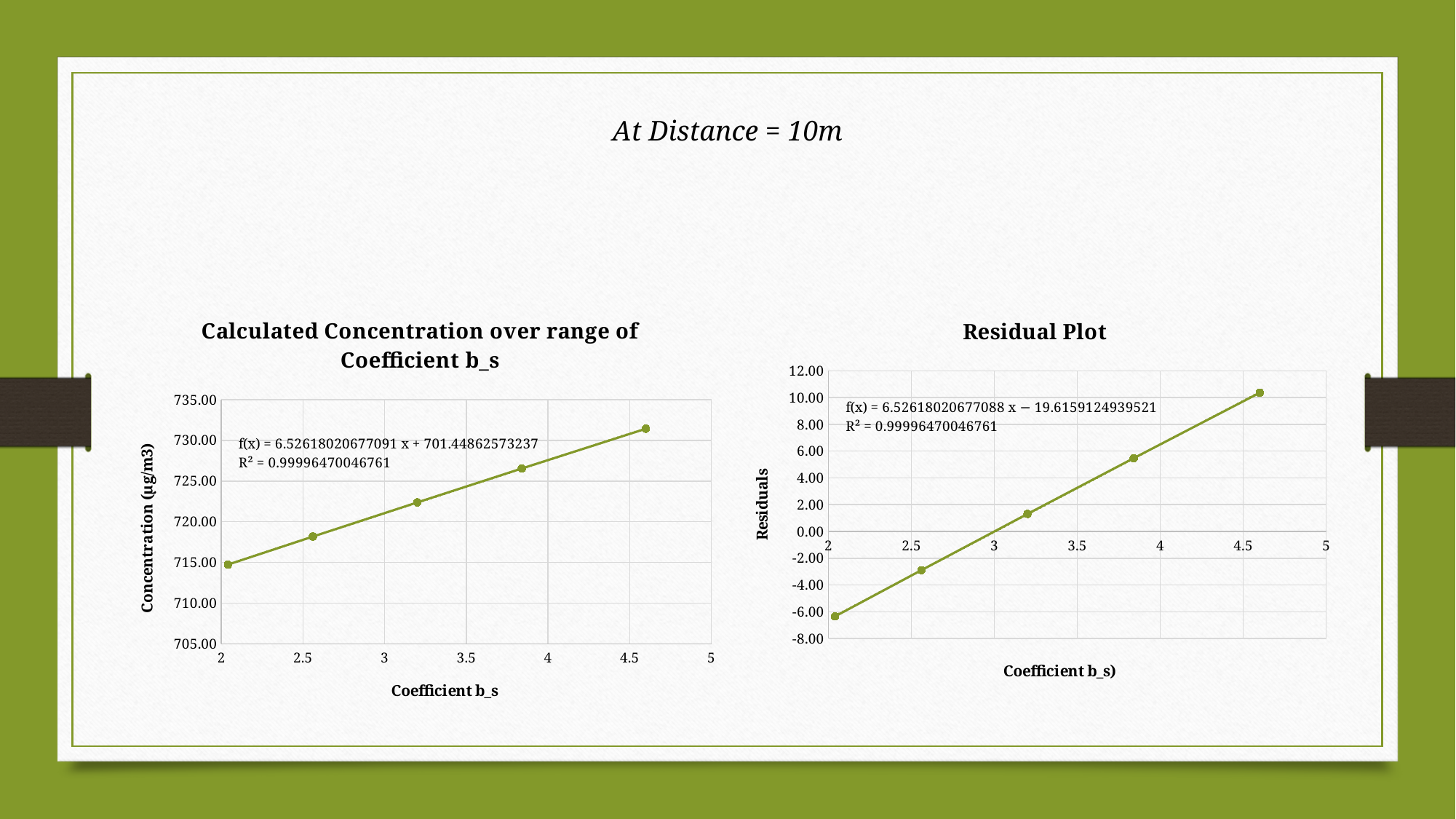
How many data points are plotted on the 'Calculated Concentration over range of Coefficient b_s' chart? 5 On the 'Residual Plot' chart, is the residual at the lowest Coefficient b_s value greater or less than -4.00? less What R² value is shown on the 'Residual Plot' chart? 0.99996470046761 On the 'Calculated Concentration over range of Coefficient b_s' chart, is the concentration at the lowest Coefficient b_s value greater or less than 720.00? less What is the y-axis title of the 'Calculated Concentration over range of Coefficient b_s' chart? Concentration (µg/m3) On the 'Calculated Concentration over range of Coefficient b_s' chart, do the values rise or fall as Coefficient b_s increases? Rise On the 'Residual Plot' chart, is the residual at the highest Coefficient b_s value greater or less than 8.00? greater On the 'Residual Plot' chart, do the residuals rise or fall as Coefficient b_s increases? Rise How many data points are plotted on the 'Residual Plot' chart? 5 What type of chart is the 'Calculated Concentration over range of Coefficient b_s' chart? Line chart